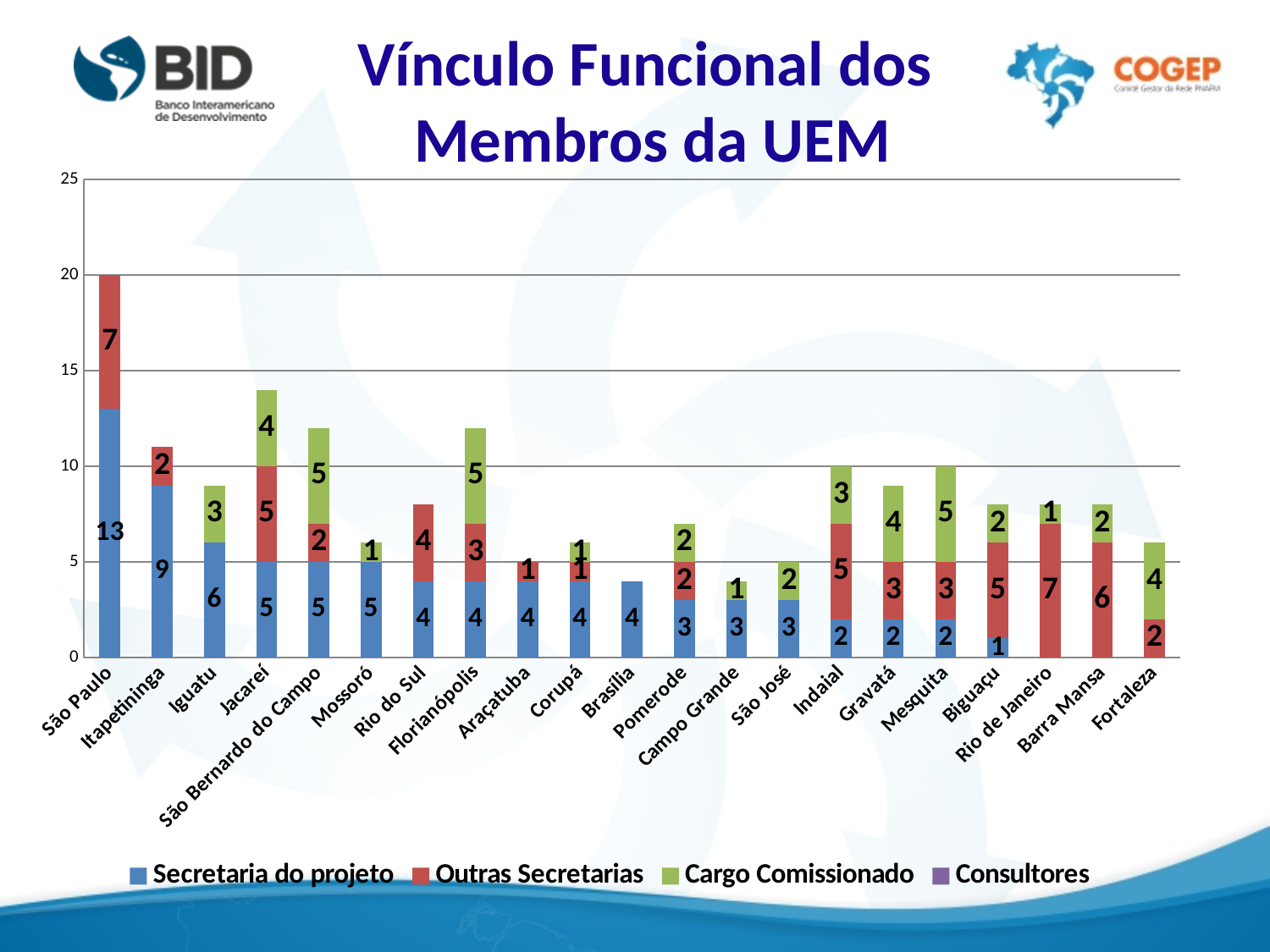
What is the value of Cargo Comissionado for Florianópolis? 5 How many cities are shown on the x axis? 21 How many series does the legend list? 4 Which is larger: the Outras Secretarias value for Biguaçu or for Gravatá? Biguaçu What is the difference between the Secretaria do projeto values for São Paulo and Itapetininga? 4 Which series is shown in green in the legend? Cargo Comissionado What is the value of Outras Secretarias for Rio de Janeiro? 7 What is the total of the stacked bar for Jacareí? 14 What is the total of the stacked bar for Indaial? 10 Which city has the highest total stacked bar? São Paulo What type of chart is shown on the slide? Stacked bar chart What is the value of Secretaria do projeto for São Paulo? 13